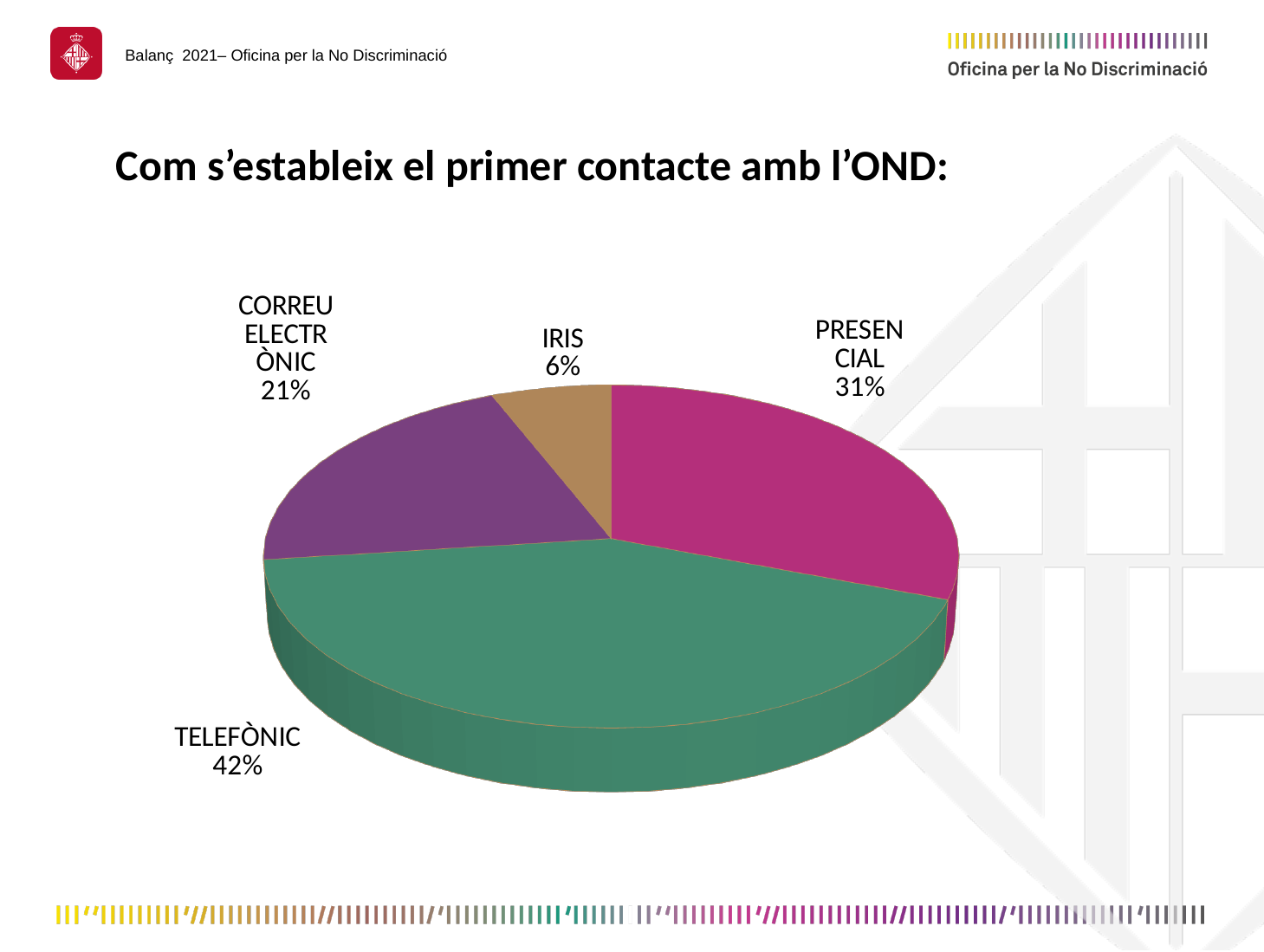
What share of first contacts is PRESENCIAL? 31% How many slices does the pie chart have? 4 What is the difference in percentage points between TELEFÒNIC and PRESENCIAL? 11 What type of chart is shown on the slide? Pie chart What share of first contacts with the OND is TELEFÒNIC? 42% Which contact channel has the smallest share? IRIS Which contact channel has the largest share? TELEFÒNIC Which is larger, the share for PRESENCIAL or for CORREU ELECTRÒNIC? PRESENCIAL What share of first contacts is CORREU ELECTRÒNIC? 21% What is the difference in percentage points between CORREU ELECTRÒNIC and IRIS? 15 What is the title of the chart on the slide? Com s’estableix el primer contacte amb l’OND: